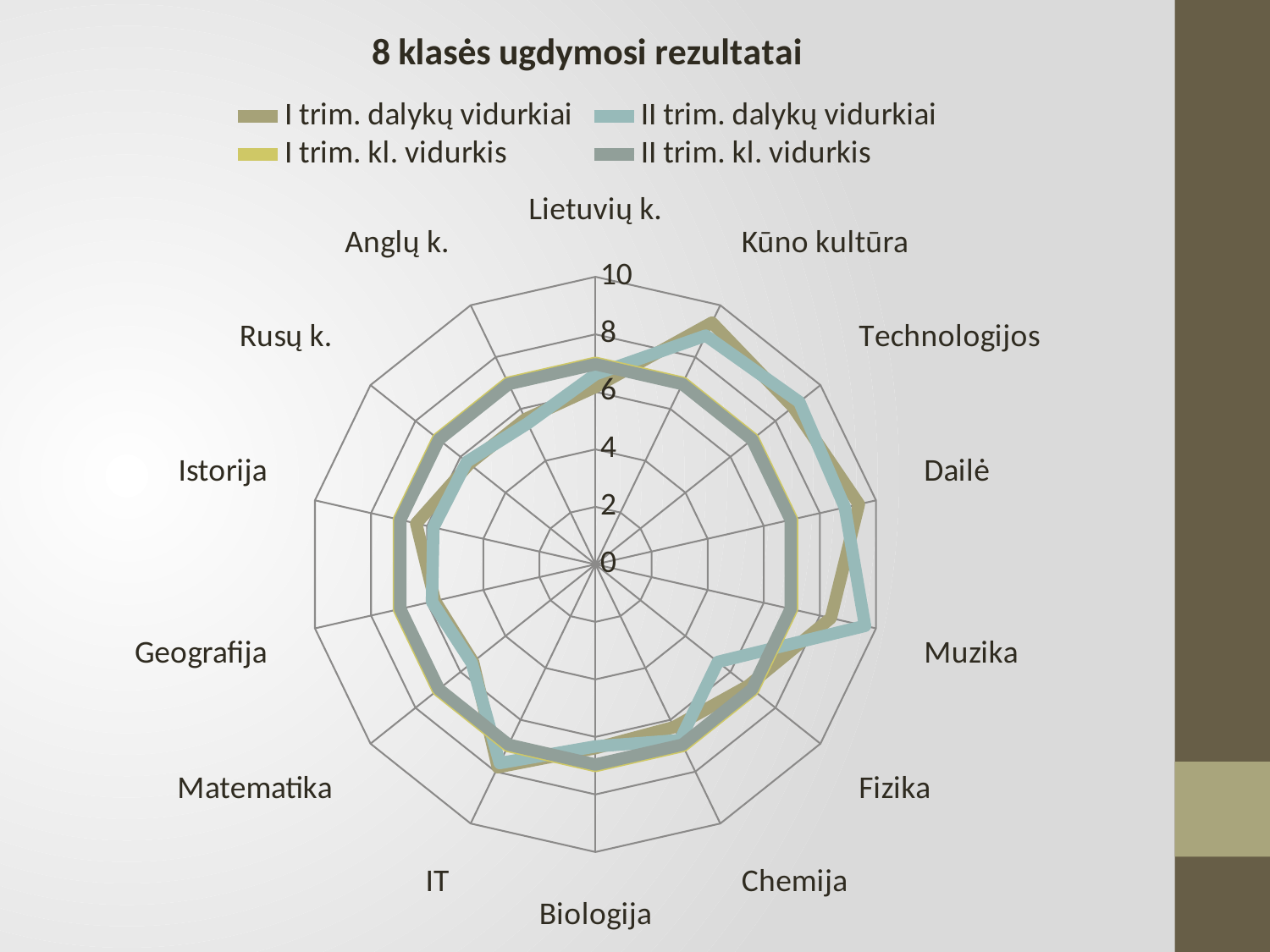
What kind of chart is shown on the slide? radar chart What is the title of the chart? 8 klasės ugdymosi rezultatai For Muzika, which series has the larger value: I trim. dalykų vidurkiai or II trim. dalykų vidurkiai? II trim. dalykų vidurkiai Is the value for Muzika in the II trim. dalykų vidurkiai series greater or less than 8? greater For Istorija, which series has the larger value: I trim. dalykų vidurkiai or II trim. dalykų vidurkiai? I trim. dalykų vidurkiai How many subject categories are plotted around the radar chart? 14 What is the maximum value shown on the radar chart's axis scale? 10 How many series does the legend list? 4 Is the value for Lietuvių k. in the I trim. dalykų vidurkiai series greater or less than 8? less Which category has the highest value for the II trim. dalykų vidurkiai series? Muzika Is the value for Kūno kultūra in the I trim. dalykų vidurkiai series greater or less than 8? greater